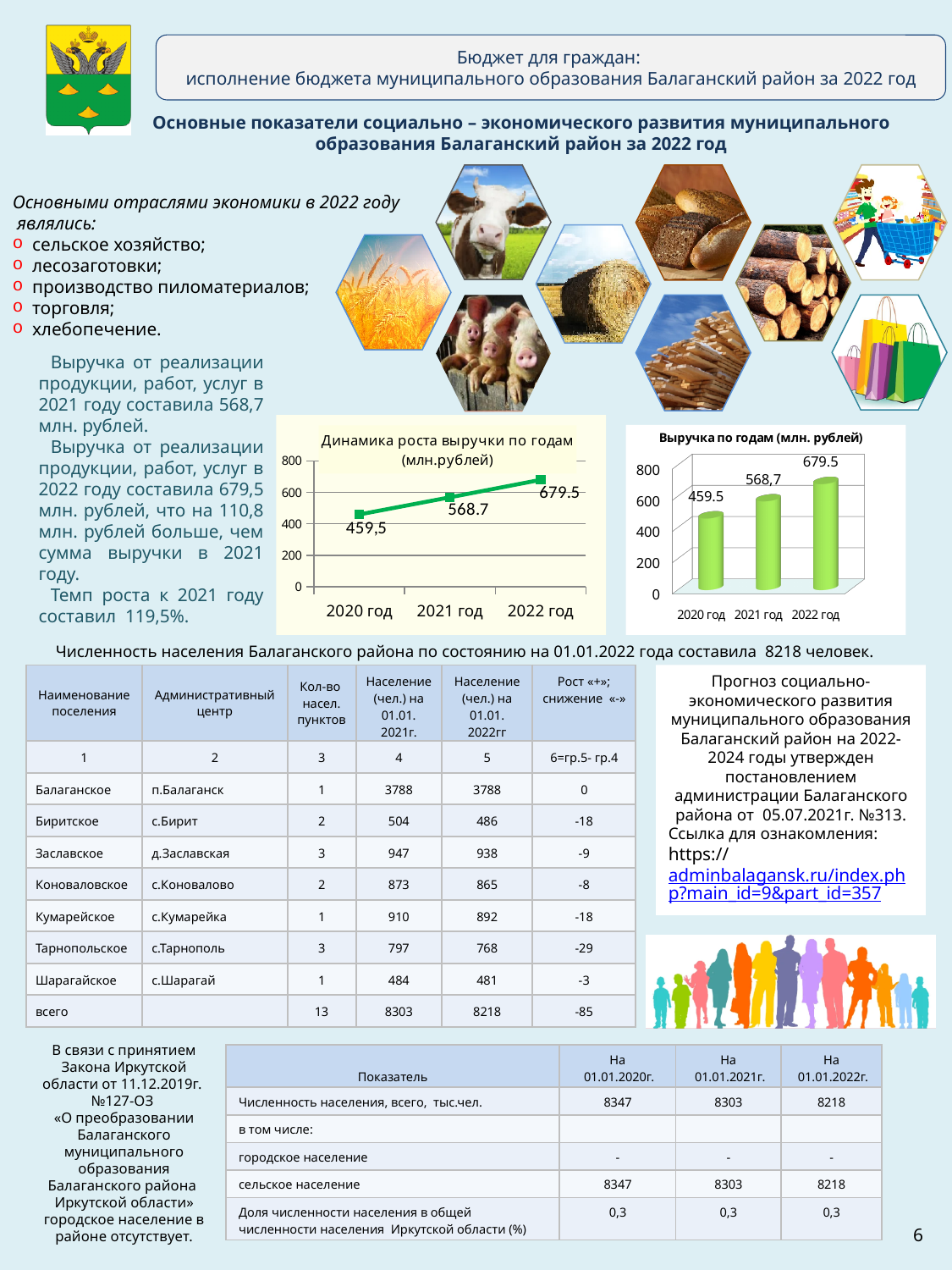
On the bar chart titled "Выручка по годам (млн. рублей)", is the value for 2021 год greater or less than 600? less On the bar chart titled "Выручка по годам (млн. рублей)", which year has the highest value? 2022 год On the line chart titled "Динамика роста выручки по годам (млн.рублей)", do the values rise or fall from 2020 год to 2022 год? rise On the bar chart titled "Выручка по годам (млн. рублей)", what is the difference between the values for 2022 год and 2021 год? 110.8 What kind of chart is the one titled "Выручка по годам (млн. рублей)"? bar chart On the line chart titled "Динамика роста выручки по годам (млн.рублей)", what is the value for 2020 год? 459,5 How many years are plotted on the line chart titled "Динамика роста выручки по годам (млн.рублей)"? 3 On the bar chart titled "Выручка по годам (млн. рублей)", what is the value for 2022 год? 679.5 On the line chart titled "Динамика роста выручки по годам (млн.рублей)", what is the value for 2021 год? 568.7 On the line chart titled "Динамика роста выручки по годам (млн.рублей)", which is larger: the value for 2020 год or 2022 год? 2022 год On the line chart titled "Динамика роста выручки по годам (млн.рублей)", which year has the lowest value? 2020 год On the bar chart titled "Выручка по годам (млн. рублей)", what is the difference between the values for 2021 год and 2020 год? 109.2